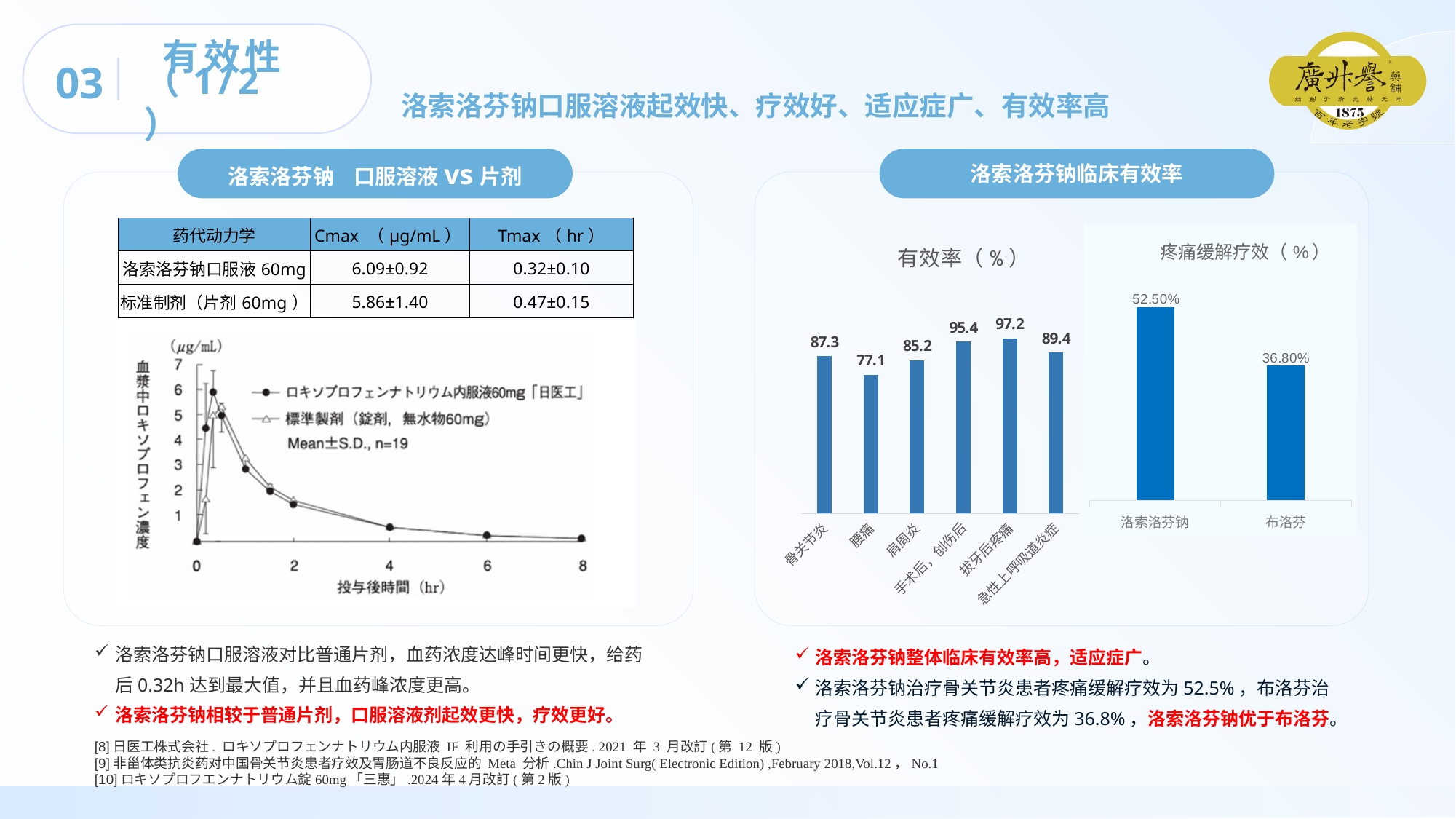
In the 疼痛缓解疗效（%） chart, what is the value for 洛索洛芬钠? 52.50% In the 有效率（%） chart, which category has the highest value? 拔牙后疼痛 In the 有效率（%） chart, which is larger: 急性上呼吸道炎症 or 骨关节炎? 急性上呼吸道炎症 In the 有效率（%） chart, what is the value for 骨关节炎? 87.3 What kind of chart is the chart at the bottom left of the slide showing plasma concentration over time? Line chart How many categories are shown in the 有效率（%） chart? 6 In the 有效率（%） chart, what is the value for 拔牙后疼痛? 97.2 In the 有效率（%） chart, which category has the lowest value? 腰痛 In the 疼痛缓解疗效（%） chart, what is the difference between 洛索洛芬钠 and 布洛芬? 15.70% In the 有效率（%） chart, what is the difference between 手术后、创伤后 and 肩周炎? 10.2 In the 疼痛缓解疗效（%） chart, what is the value for 布洛芬? 36.80% What kind of chart is the 有效率（%） chart? Bar chart